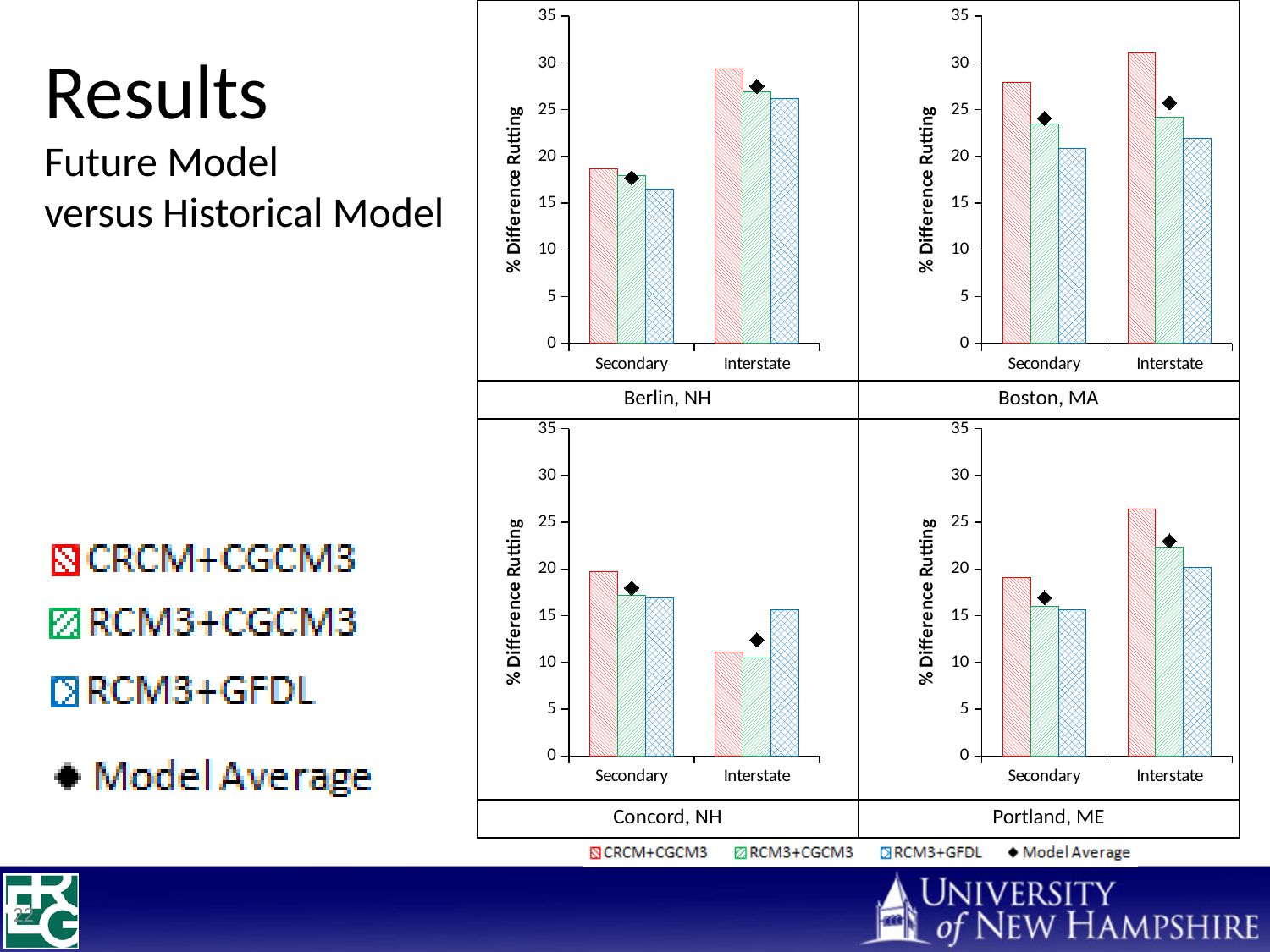
In the Concord, NH chart, is the Interstate value for RCM3+CGCM3 greater or less than 15? less In the Portland, ME chart, which model has the lowest Interstate value? RCM3+GFDL In the Portland, ME chart, does the CRCM+CGCM3 value rise or fall from Secondary to Interstate? rise What kind of chart is used for Berlin, NH? bar chart What is the y-axis label on the Berlin, NH chart? % Difference Rutting In the Boston, MA chart, is the Interstate value for CRCM+CGCM3 greater or less than 25? greater How many categories are shown on the x axis of the Concord, NH chart? 2 In the Boston, MA chart, which model has the highest Secondary value? CRCM+CGCM3 How many entries does the legend at the bottom of the slide list? 4 In the Concord, NH chart, which is larger for Interstate: CRCM+CGCM3 or RCM3+GFDL? RCM3+GFDL In the Berlin, NH chart, is the Interstate value for CRCM+CGCM3 greater or less than 25? greater In the Concord, NH chart, does the CRCM+CGCM3 value rise or fall from Secondary to Interstate? fall